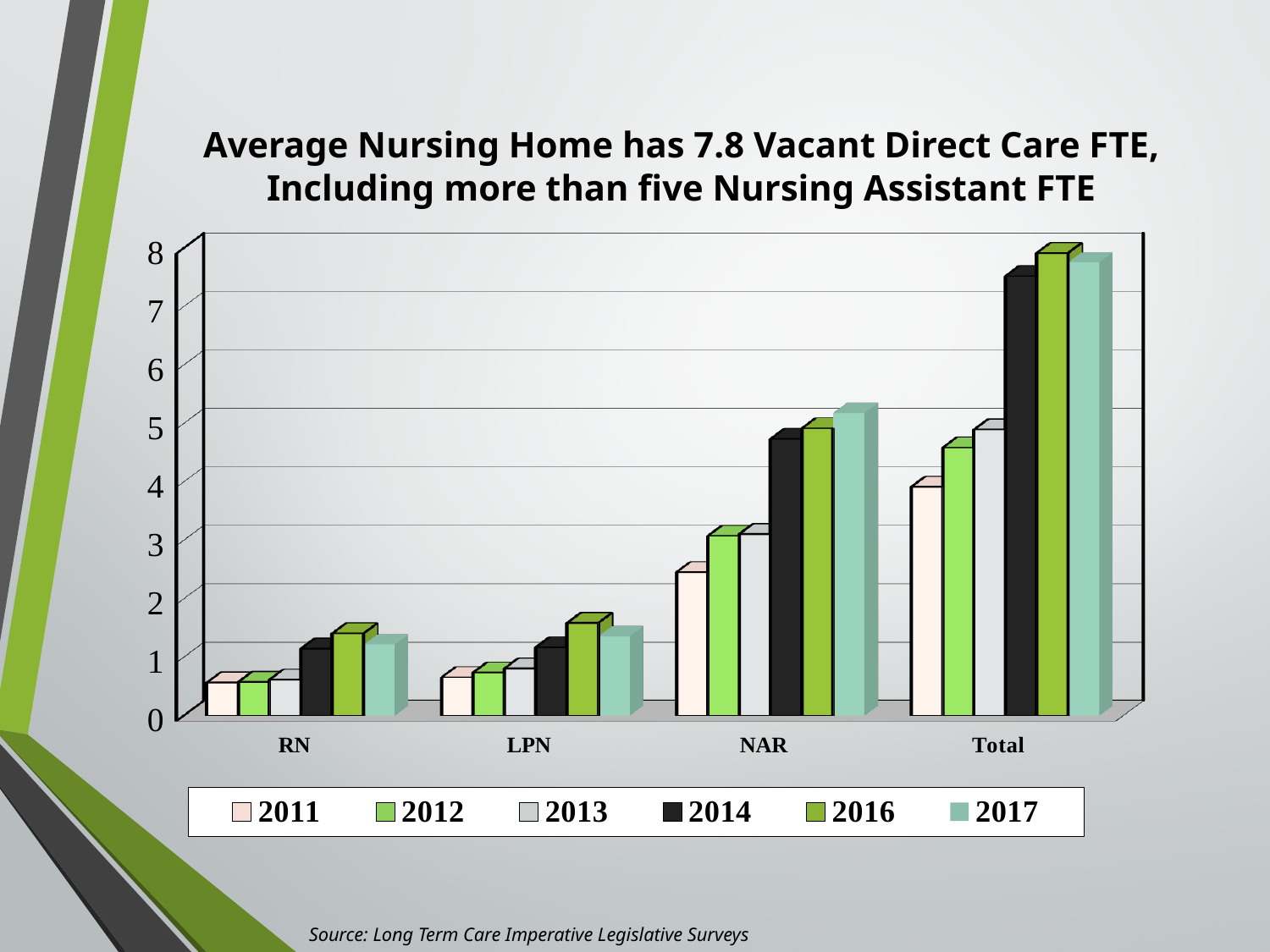
Is the value for Total in 2014 greater or less than 7? greater What source is cited below the chart? Long Term Care Imperative Legislative Surveys Do the 2011 values rise or fall moving from RN to Total along the x axis? rise Is the value for RN in 2011 greater or less than 1? less Which category has the highest value for 2017? Total Which year has the lowest value for NAR? 2011 Is the value for NAR in 2011 greater or less than 3? less How many series does the chart's legend list? 6 For NAR, which is larger: the 2011 value or the 2014 value? 2014 What kind of chart is shown on the slide? bar chart How many categories are shown on the x axis of the chart? 4